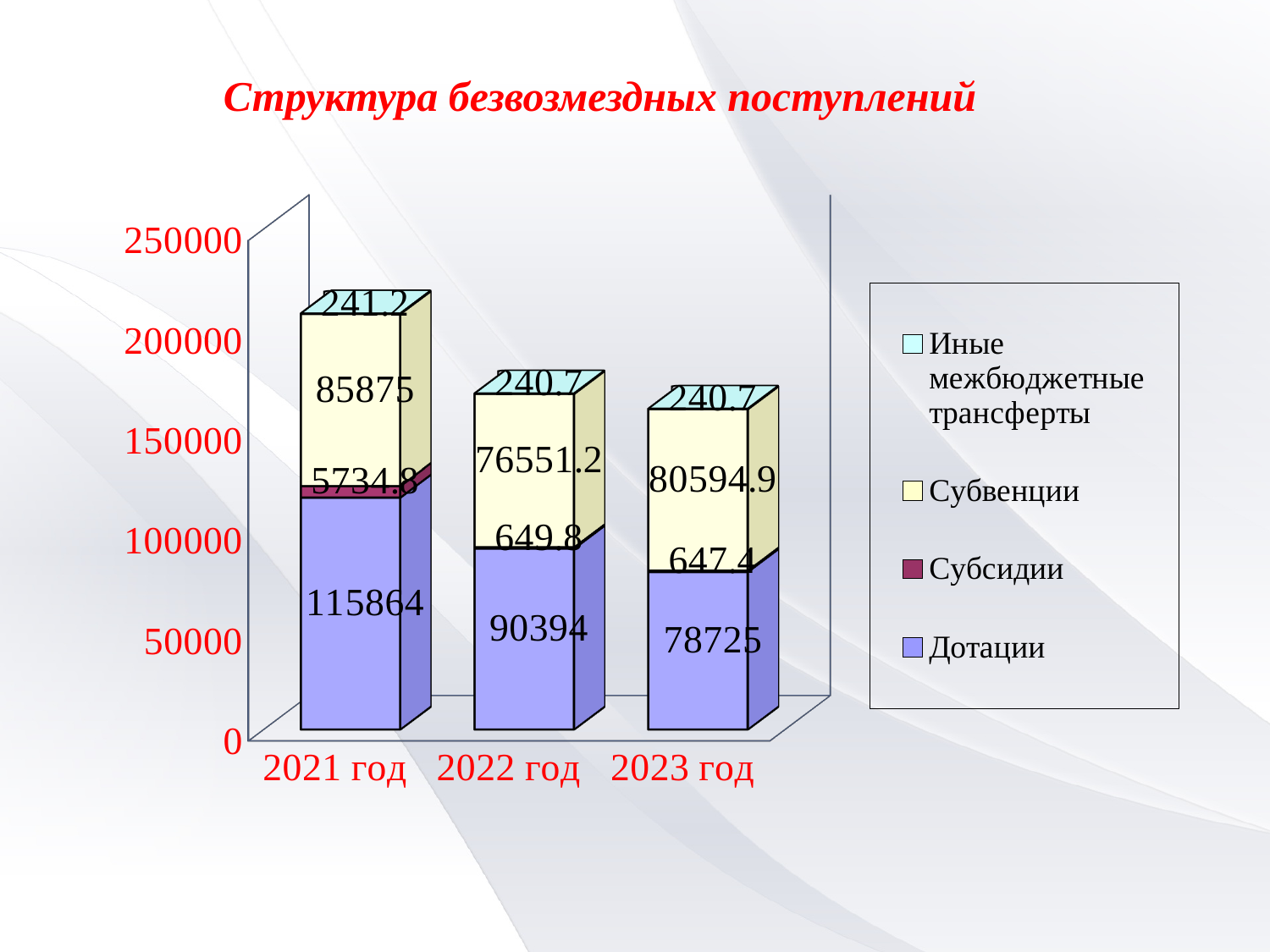
What is the value of Дотации for 2021 год? 115864 What kind of chart is shown on the slide? Stacked bar chart What is the difference between the Дотации values for 2021 год and 2022 год? 25470 In which year is the value of Дотации the highest? 2021 год Which is larger: Субвенции for 2023 год or Субвенции for 2022 год? Субвенции for 2023 год What is the value of Иные межбюджетные трансферты for 2021 год? 241.2 What is the value of Субсидии for 2023 год? 647.4 In which year is the value of Субвенции the lowest? 2022 год Do the Дотации values rise or fall from 2021 год to 2023 год? Fall What is the total of the stacked bar for 2022 год? 167835.7 What is the value of Субвенции for 2022 год? 76551.2 How many series does the legend list? 4